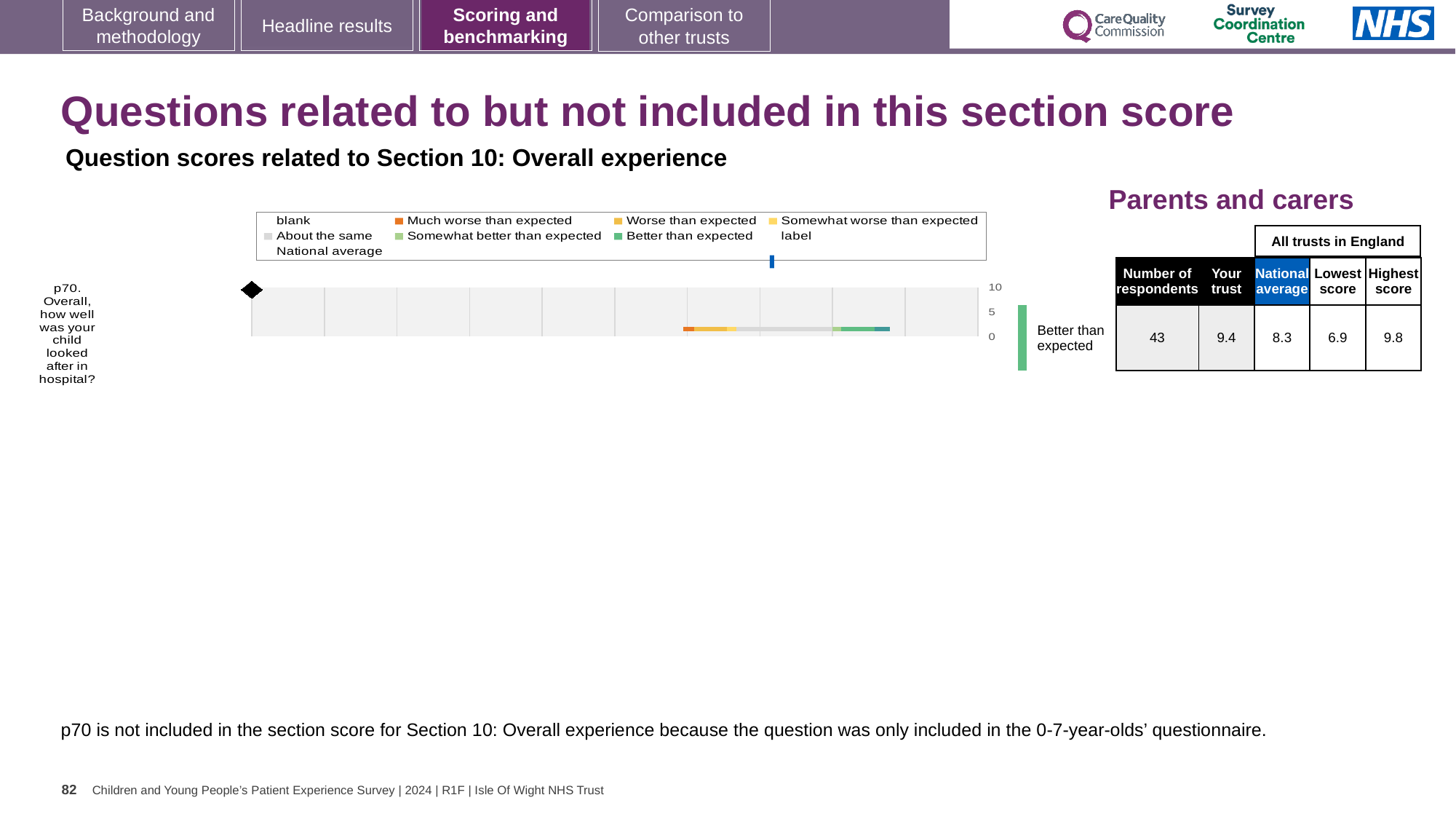
What is the highest tick value shown on the chart's axis? 10 What kind of chart is used to show the p70 question score? bar chart What rating label is shown to the right of the p70 bar? Better than expected In the table beside the chart, what is the highest score among all trusts in England for p70? 9.8 How many survey questions are plotted in the chart? 1 Which is larger for p70: the 'Your trust' score or the national average? Your trust In the table beside the chart, what is the national average score for p70? 8.3 What is the difference between the 'Your trust' score and the national average for p70? 1.1 In the table beside the chart, how many respondents answered p70? 43 What is the difference between the highest and lowest scores among all trusts in England for p70? 2.9 In the table beside the chart, what is the 'Your trust' score for p70? 9.4 In the table beside the chart, what is the lowest score among all trusts in England for p70? 6.9